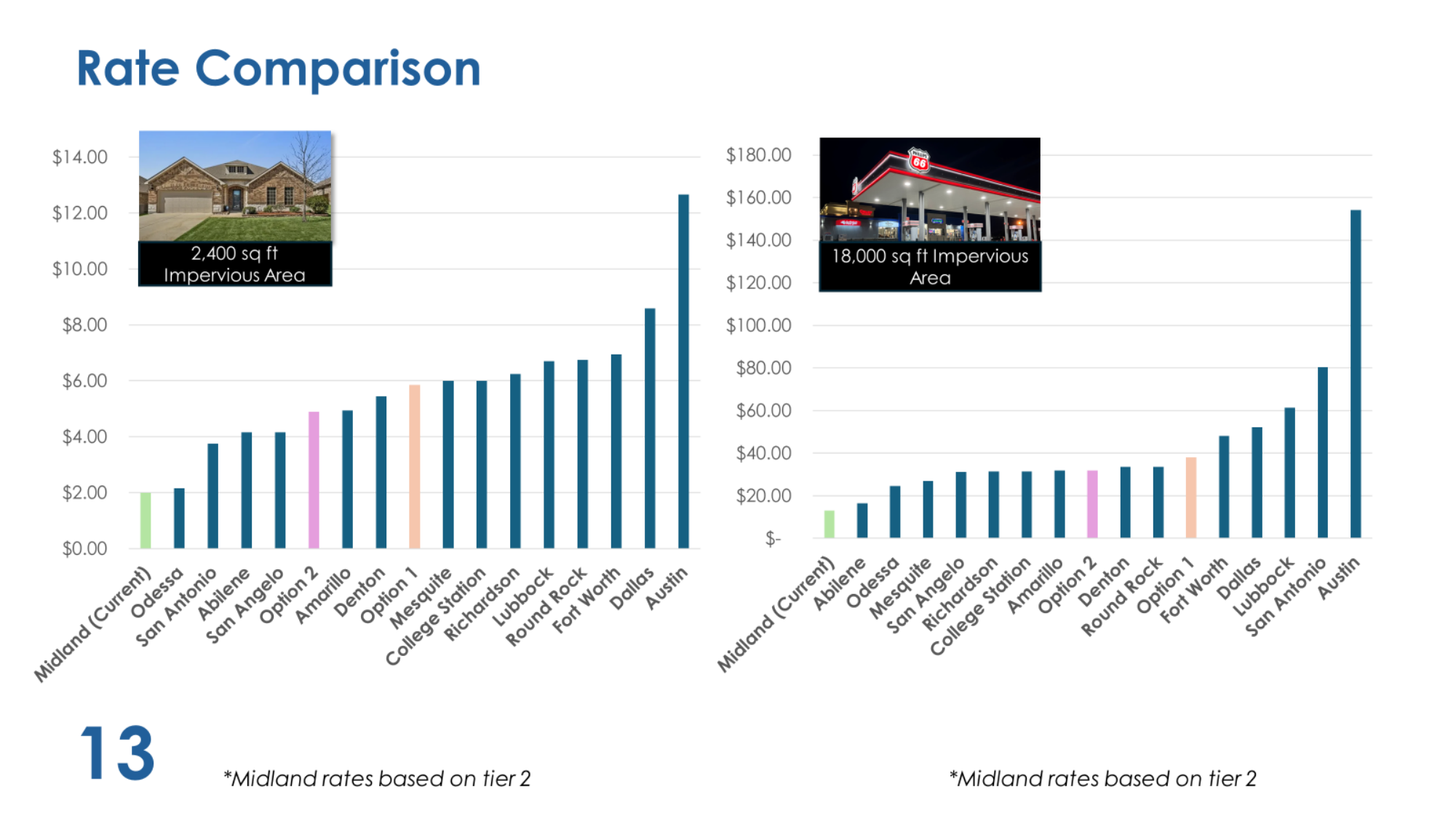
In the left chart (2,400 sq ft Impervious Area), is the value for Dallas greater or less than $10.00? less In the left chart (2,400 sq ft Impervious Area), do the values generally rise or fall from left to right along the x axis? Rise In the left chart (2,400 sq ft Impervious Area), which category has the lowest rate? Midland (Current) In the left chart (2,400 sq ft Impervious Area), which city has the highest rate? Austin In the right chart (18,000 sq ft Impervious Area), which category has the lowest rate? Midland (Current) In the right chart (18,000 sq ft Impervious Area), which city has the highest rate? Austin In the right chart (18,000 sq ft Impervious Area), is the value for Austin greater or less than $140.00? greater In the right chart (18,000 sq ft Impervious Area), which is larger, the value for Dallas or the value for Lubbock? Lubbock In the right chart (18,000 sq ft Impervious Area), is the value for San Antonio greater or less than $100.00? less What kind of chart is the right chart (18,000 sq ft Impervious Area)? Bar chart How many bars are plotted in the left chart (2,400 sq ft Impervious Area)? 17